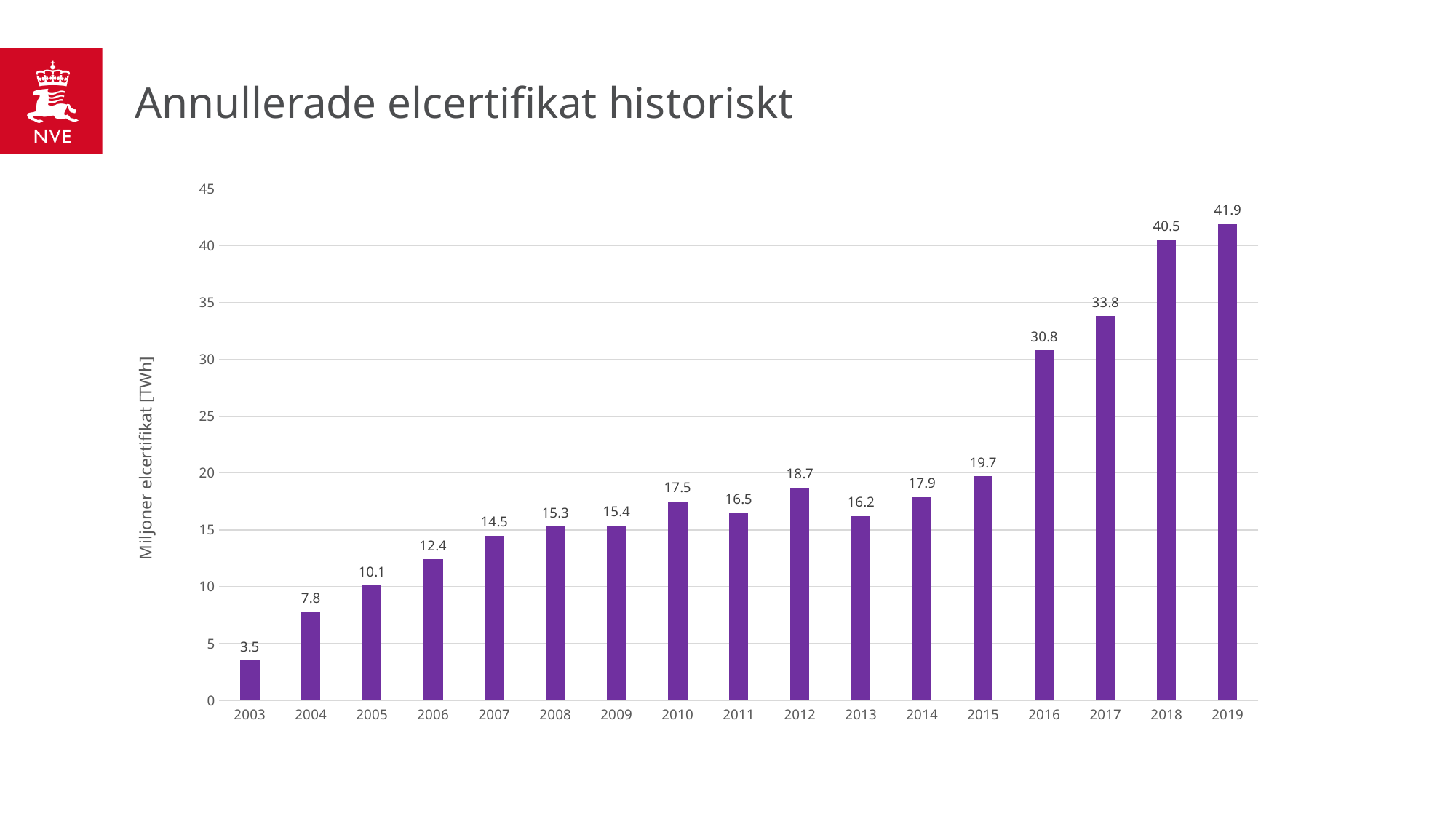
What kind of chart is shown on the slide? bar chart How many years are shown on the x axis? 17 What is the value for 2010? 17.5 Which year has the highest value? 2019 What is the value for 2003? 3.5 What is the difference between the values for 2019 and 2018? 1.4 What is the label of the y axis? Miljoner elcertifikat [TWh] Is the value for 2015 greater or less than 20? less Which is larger, the value for 2012 or the value for 2013? 2012 What is the difference between the values for 2017 and 2016? 3.0 Which year has the lowest value? 2003 What is the value for 2016? 30.8